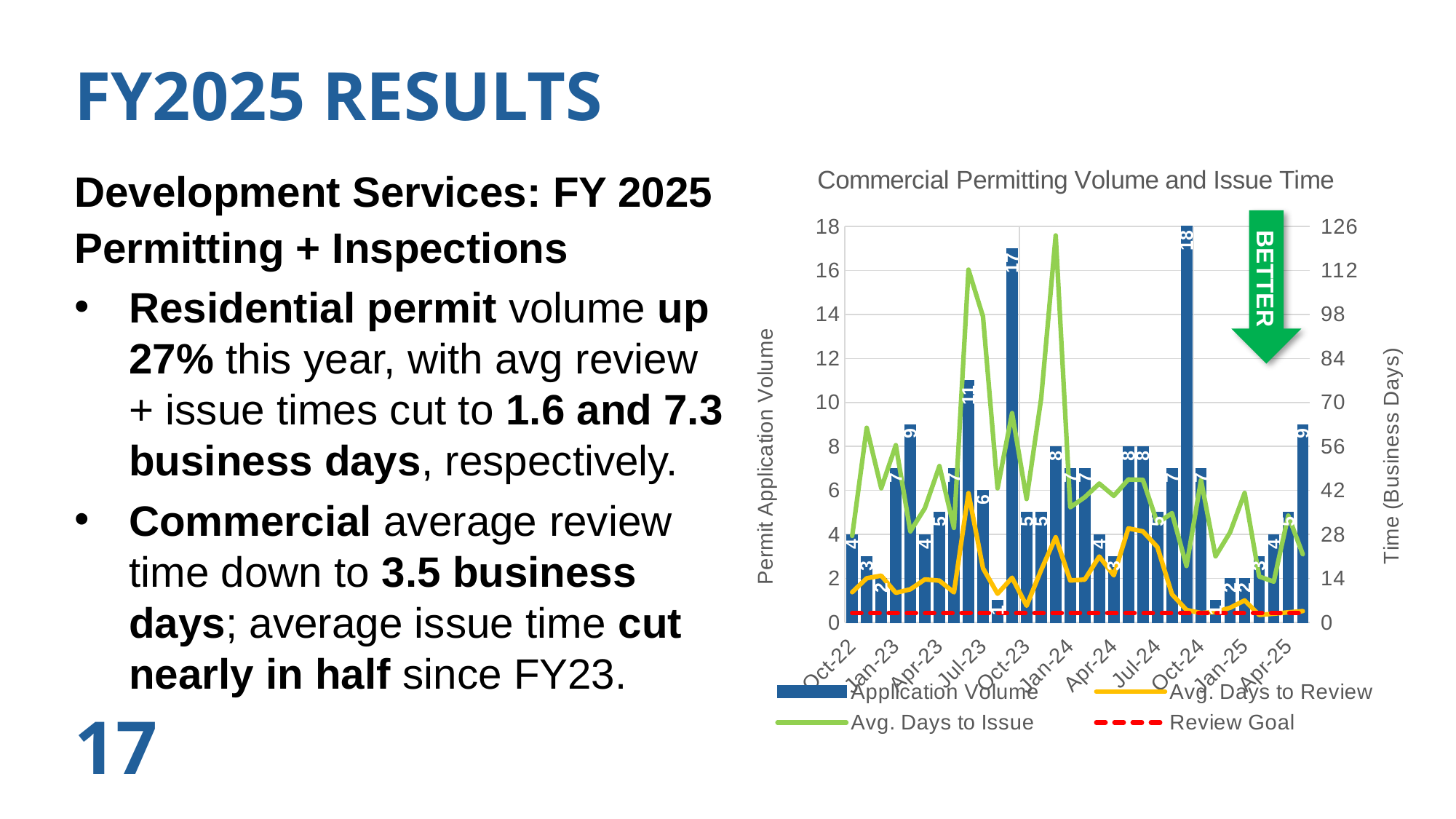
What is the first month label on the x axis of the chart? Oct-22 What is the last month label on the x axis of the chart? Apr-25 Is the peak of the Avg. Days to Issue line greater or less than 98 business days? greater Which series in the chart is drawn as bars? Application Volume What is the highest Application Volume value labeled on the chart? 18 Is the Review Goal dashed line greater or less than 14 business days? less What is the maximum value shown on the left vertical axis (Permit Application Volume)? 18 What is the title of the chart? Commercial Permitting Volume and Issue Time Which series is shown as a red dashed line? Review Goal Is the Avg. Days to Review line generally higher or lower than the Avg. Days to Issue line? lower How many series does the chart legend list? 4 What is the maximum value shown on the right vertical axis (Time (Business Days))? 126